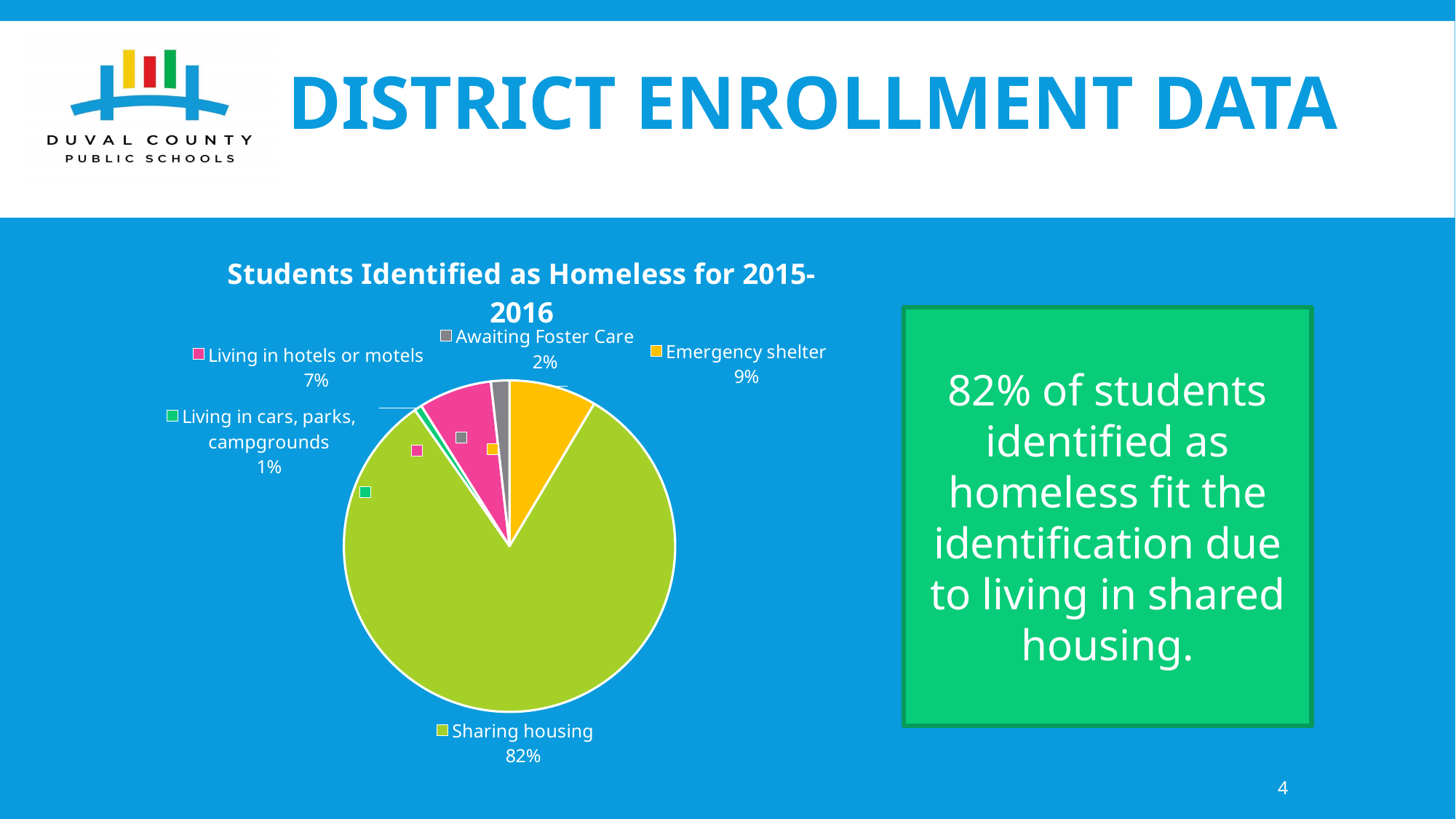
Which category has the smallest share of the pie? Living in cars, parks, campgrounds What percentage of students identified as homeless are awaiting foster care? 2% Which category has the largest share of the pie? Sharing housing What percentage of students identified as homeless are living in cars, parks, campgrounds? 1% What is the difference in percentage points between Emergency shelter and Living in hotels or motels? 2 Which is larger: the share for Emergency shelter or the share for Awaiting Foster Care? Emergency shelter What is the title of the chart? Students Identified as Homeless for 2015-2016 What percentage of students identified as homeless are in an emergency shelter? 9% What percentage of students identified as homeless are sharing housing? 82% How many categories are shown in the pie chart? 5 What type of chart is shown on the slide? pie chart What percentage of students identified as homeless are living in hotels or motels? 7%